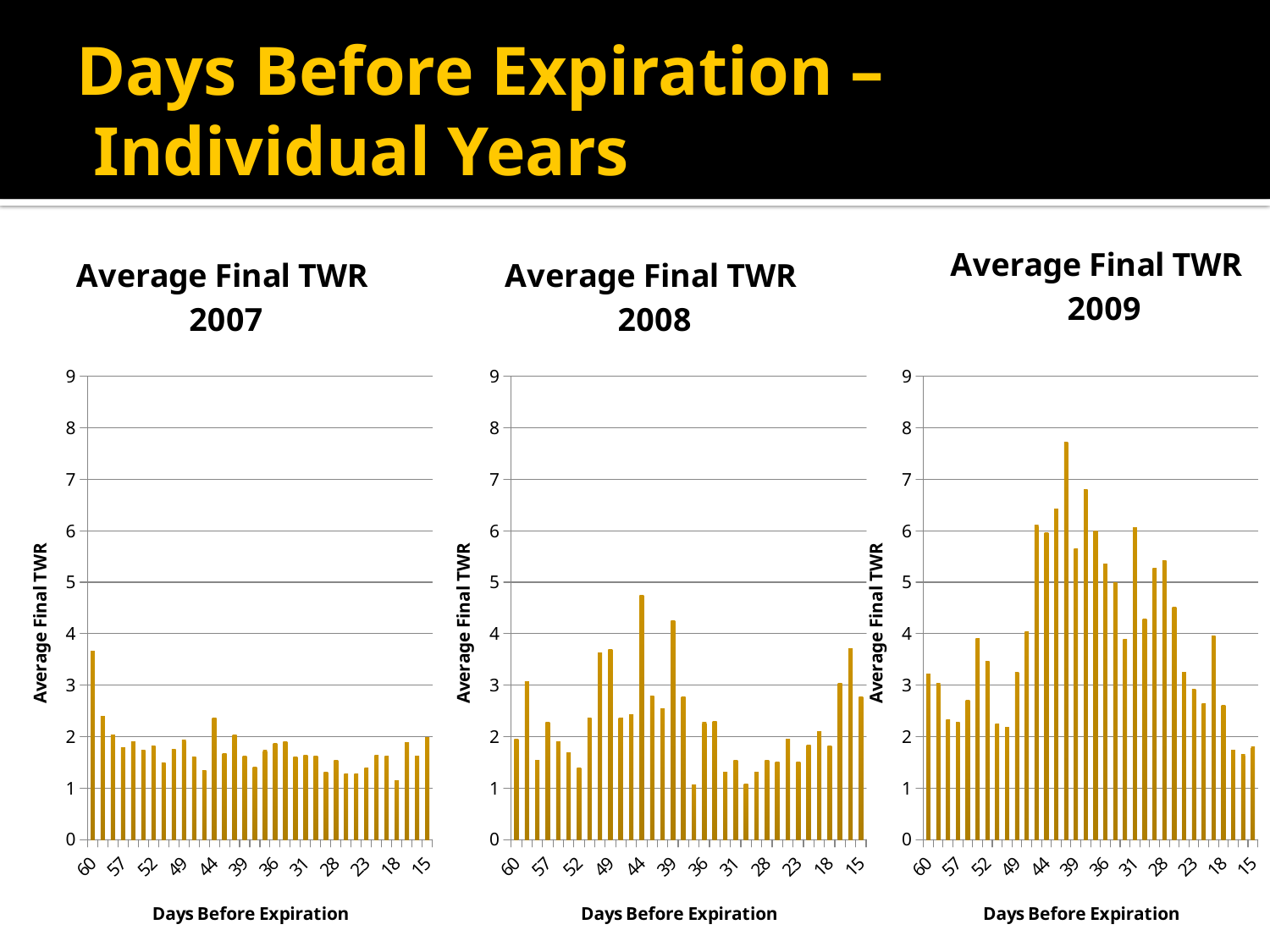
In the Average Final TWR 2007 chart, which days-before-expiration value has the highest bar? 60 Which of the three charts contains the tallest bar overall? Average Final TWR 2009 What kind of chart is the Average Final TWR 2007 chart? Bar chart In the Average Final TWR 2009 chart, do the values generally rise or fall from 39 days to 15 days before expiration? fall In the Average Final TWR 2008 chart, which days-before-expiration value has the highest bar? 44 In the Average Final TWR 2009 chart, is the value for 60 days before expiration greater or less than 4? less In the Average Final TWR 2007 chart, is the value for 60 days before expiration greater or less than 3? greater In the Average Final TWR 2008 chart, is the value for 44 days before expiration greater or less than 4? greater What is the maximum value shown on the y axis of the Average Final TWR 2008 chart? 9